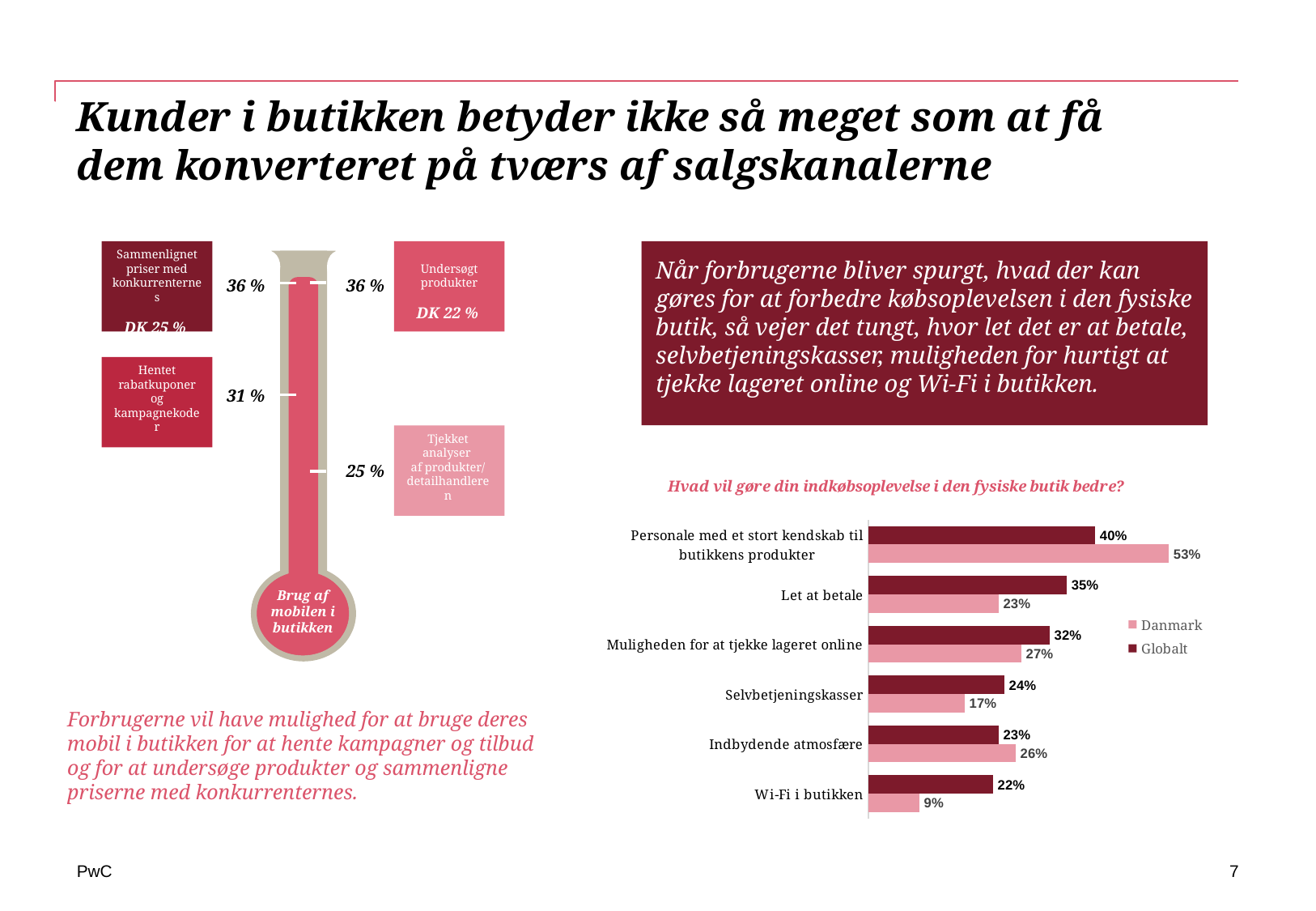
How many series does the legend of the chart 'Hvad vil gøre din indkøbsoplevelse i den fysiske butik bedre?' list? 2 How many categories are shown in the chart 'Hvad vil gøre din indkøbsoplevelse i den fysiske butik bedre?'? 6 In the chart 'Hvad vil gøre din indkøbsoplevelse i den fysiske butik bedre?', which category has the lowest Danmark value? Wi-Fi i butikken In the chart 'Hvad vil gøre din indkøbsoplevelse i den fysiske butik bedre?', which is larger for 'Selvbetjeningskasser': the Danmark value or the Globalt value? Globalt In the chart 'Hvad vil gøre din indkøbsoplevelse i den fysiske butik bedre?', which is larger for 'Indbydende atmosfære': the Danmark value or the Globalt value? Danmark What kind of chart is 'Hvad vil gøre din indkøbsoplevelse i den fysiske butik bedre?'? Bar chart In the chart 'Hvad vil gøre din indkøbsoplevelse i den fysiske butik bedre?', what is the difference between the Danmark and Globalt values for 'Personale med et stort kendskab til butikkens produkter'? 13% In the chart 'Hvad vil gøre din indkøbsoplevelse i den fysiske butik bedre?', what is the Danmark value for 'Personale med et stort kendskab til butikkens produkter'? 53% In the chart 'Hvad vil gøre din indkøbsoplevelse i den fysiske butik bedre?', which category has the highest Globalt value? Personale med et stort kendskab til butikkens produkter In the chart 'Hvad vil gøre din indkøbsoplevelse i den fysiske butik bedre?', what is the Danmark value for 'Wi-Fi i butikken'? 9% In the chart 'Hvad vil gøre din indkøbsoplevelse i den fysiske butik bedre?', what is the Globalt value for 'Let at betale'? 35% In the chart 'Hvad vil gøre din indkøbsoplevelse i den fysiske butik bedre?', what is the difference between the Globalt and Danmark values for 'Wi-Fi i butikken'? 13%